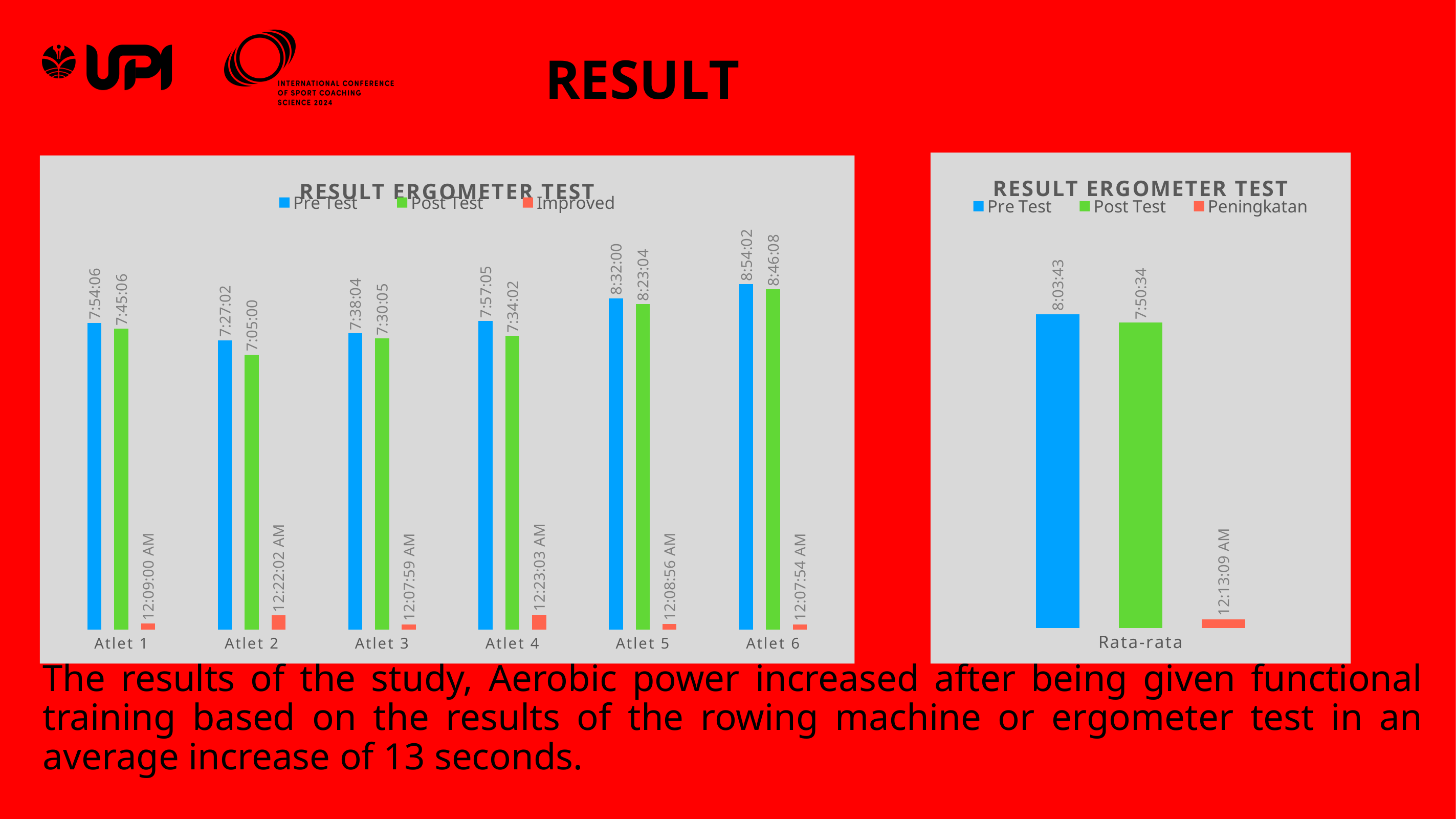
In the left chart, which athlete has the lowest Post Test value? Atlet 2 In the left chart, which athlete has the highest Pre Test value? Atlet 6 In the left chart, what is the Improved value for Atlet 4? 12:23:03 AM In the right chart, what is the Post Test value for Rata-rata? 7:50:34 In the left chart, what is the Post Test value for Atlet 6? 8:46:08 What type of chart is the right chart? Bar chart In the left chart, which is larger for Atlet 5, the Pre Test or the Post Test value? Pre Test In the left chart, what is the Post Test value for Atlet 2? 7:05:00 In the right chart, what is the Pre Test value for Rata-rata? 8:03:43 In the left chart, what is the Pre Test value for Atlet 1? 7:54:06 How many athlete categories are shown on the x axis of the left chart? 6 How many series does the legend of the left chart list? 3